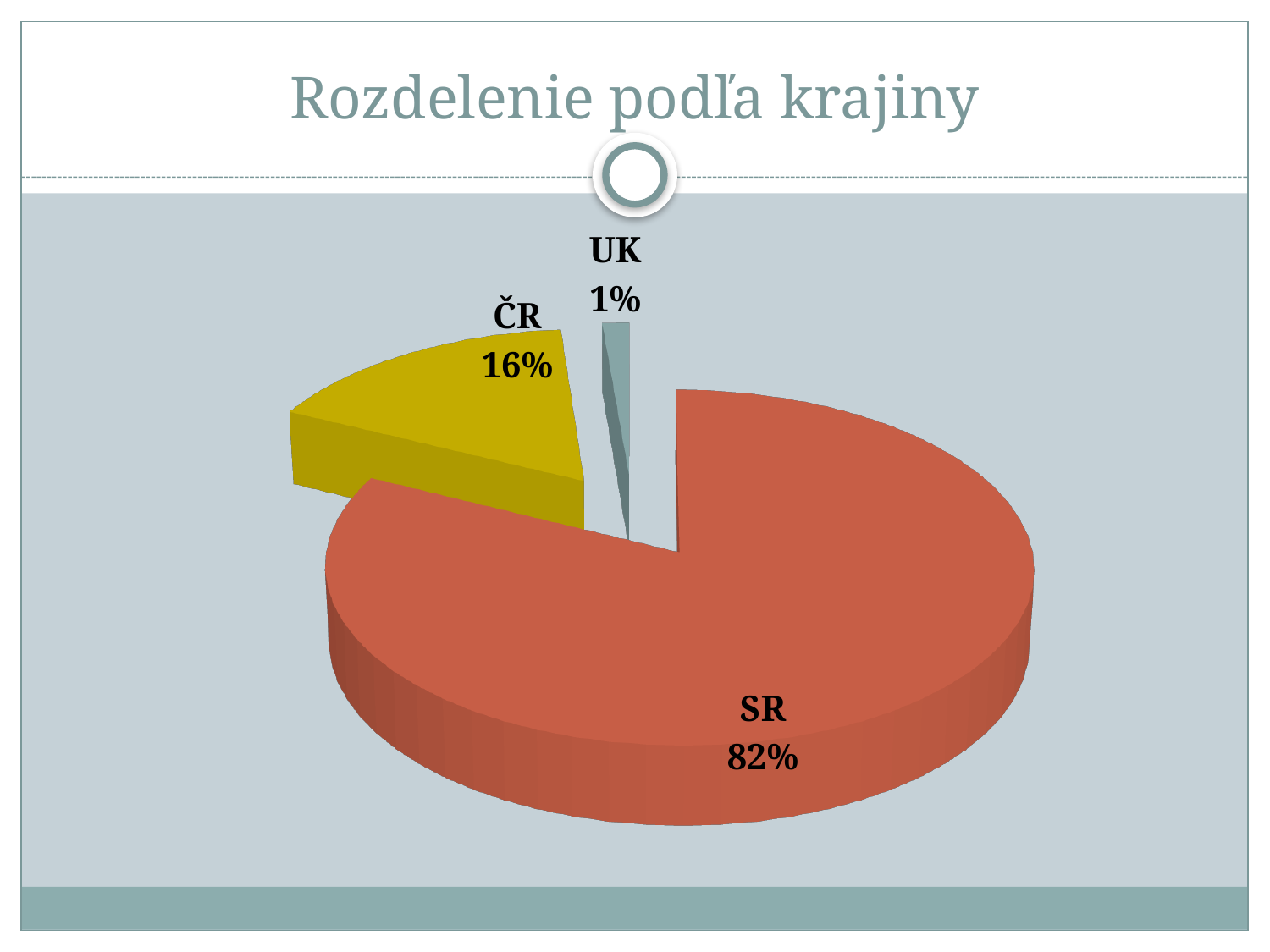
What kind of chart is shown on the slide? pie chart Which country has the smallest slice of the pie? UK What colour is the slice for SR? red What is the difference in percentage points between SR and ČR? 66 What is the difference in percentage points between ČR and UK? 15 What is the share for UK? 1% How many slices does the pie chart have? 3 Which is larger, the share for ČR or the share for UK? ČR What is the share for ČR? 16% What is the share for SR? 82% Which country has the largest slice of the pie? SR What is the title of the chart? Rozdelenie podľa krajiny